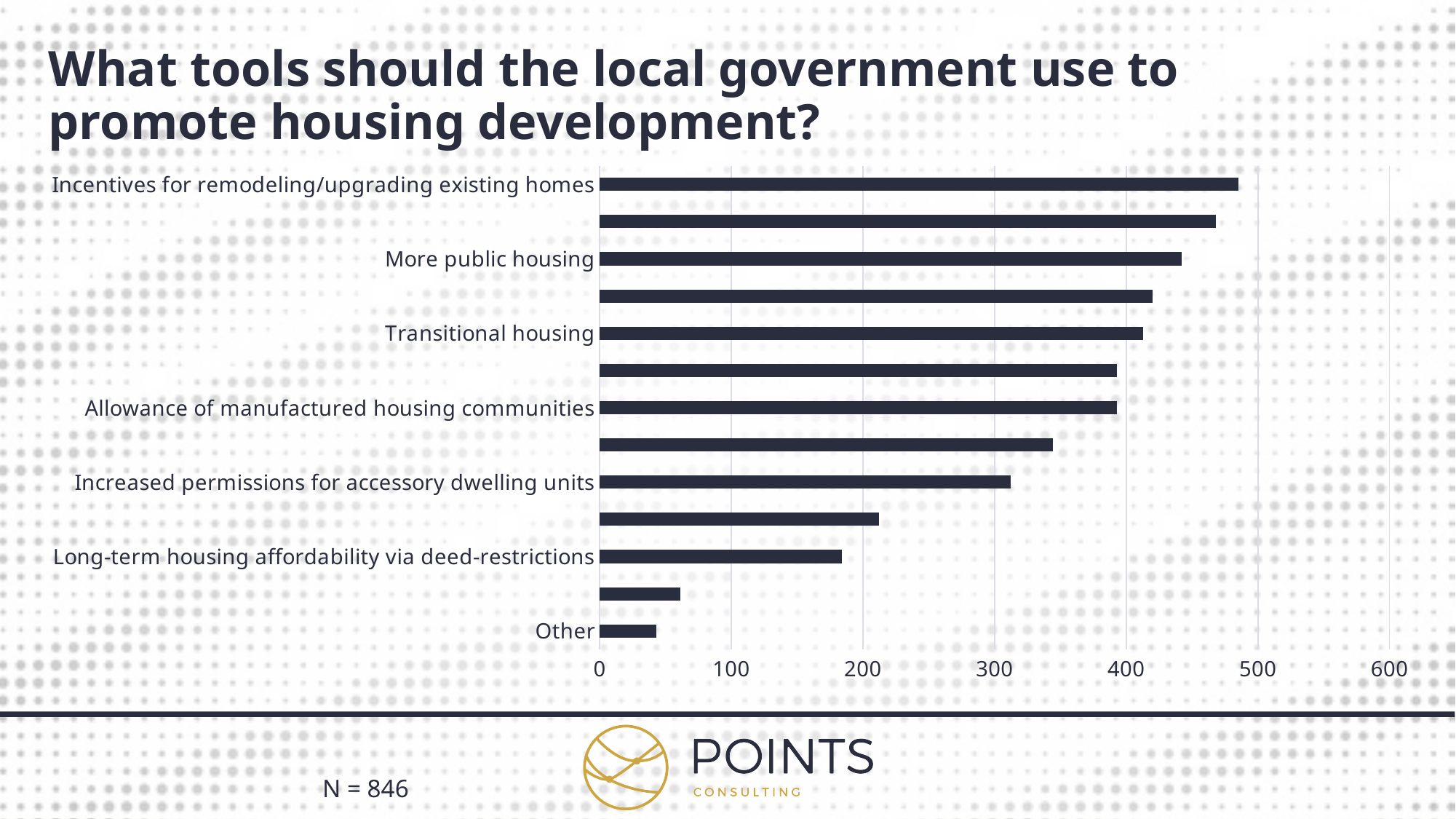
Is the value for Increased permissions for accessory dwelling units greater or less than 300? greater Which labeled category has the longest bar? Incentives for remodeling/upgrading existing homes Is the value for More public housing greater or less than 500? less Is the value for Transitional housing greater or less than 400? greater What is the sample size (N) stated on the slide? N = 846 Which is larger: the value for More public housing or the value for Allowance of manufactured housing communities? More public housing Which labeled category has the shortest bar? Other What kind of chart is shown on the slide? Bar chart How many bars are plotted in the chart? 13